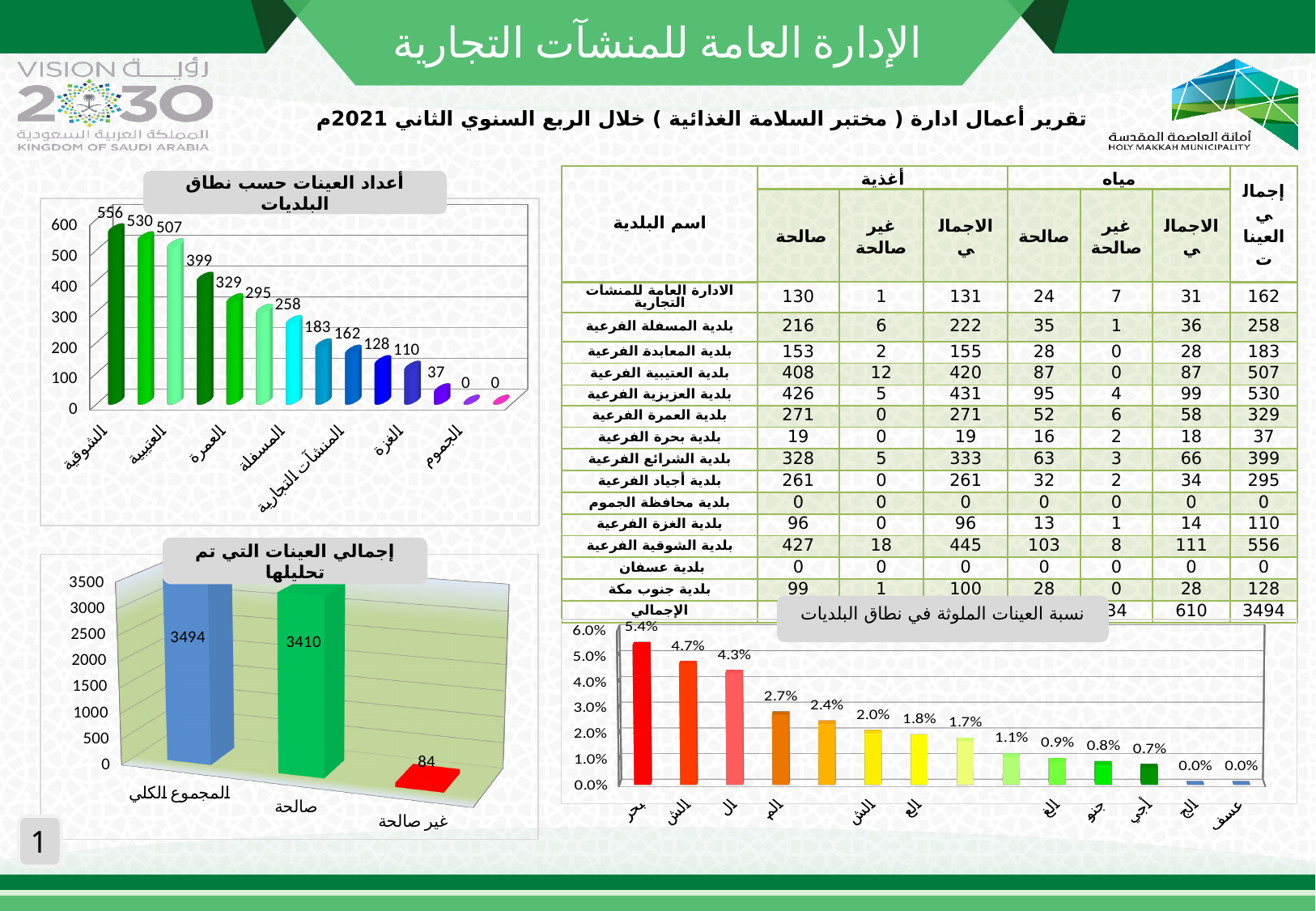
What kind of chart is the chart titled 'نسبة العينات الملوثة في نطاق البلديات'? bar chart In the chart titled 'أعداد العينات حسب نطاق البلديات', what is the value for الشوقية? 556 In the chart titled 'إجمالي العينات التي تم تحليلها', what is the value for صالحة? 3410 In the chart titled 'نسبة العينات الملوثة في نطاق البلديات', what is the highest value shown? 5.4% In the chart titled 'أعداد العينات حسب نطاق البلديات', what is the value for العتيبية? 507 In the chart titled 'أعداد العينات حسب نطاق البلديات', what is the difference between the values for الشوقية and العتيبية? 49 In the chart titled 'إجمالي العينات التي تم تحليلها', what is the value for غير صالحة? 84 In the chart titled 'أعداد العينات حسب نطاق البلديات', which category has the highest value? الشوقية In the chart titled 'أعداد العينات حسب نطاق البلديات', what is the value for المسفلة? 258 In the chart titled 'إجمالي العينات التي تم تحليلها', how many bars are plotted? 3 In the chart titled 'أعداد العينات حسب نطاق البلديات', which is larger, the value for العمرة or the value for الغزة? العمرة In the chart titled 'أعداد العينات حسب نطاق البلديات', do the values rise or fall from left to right? fall